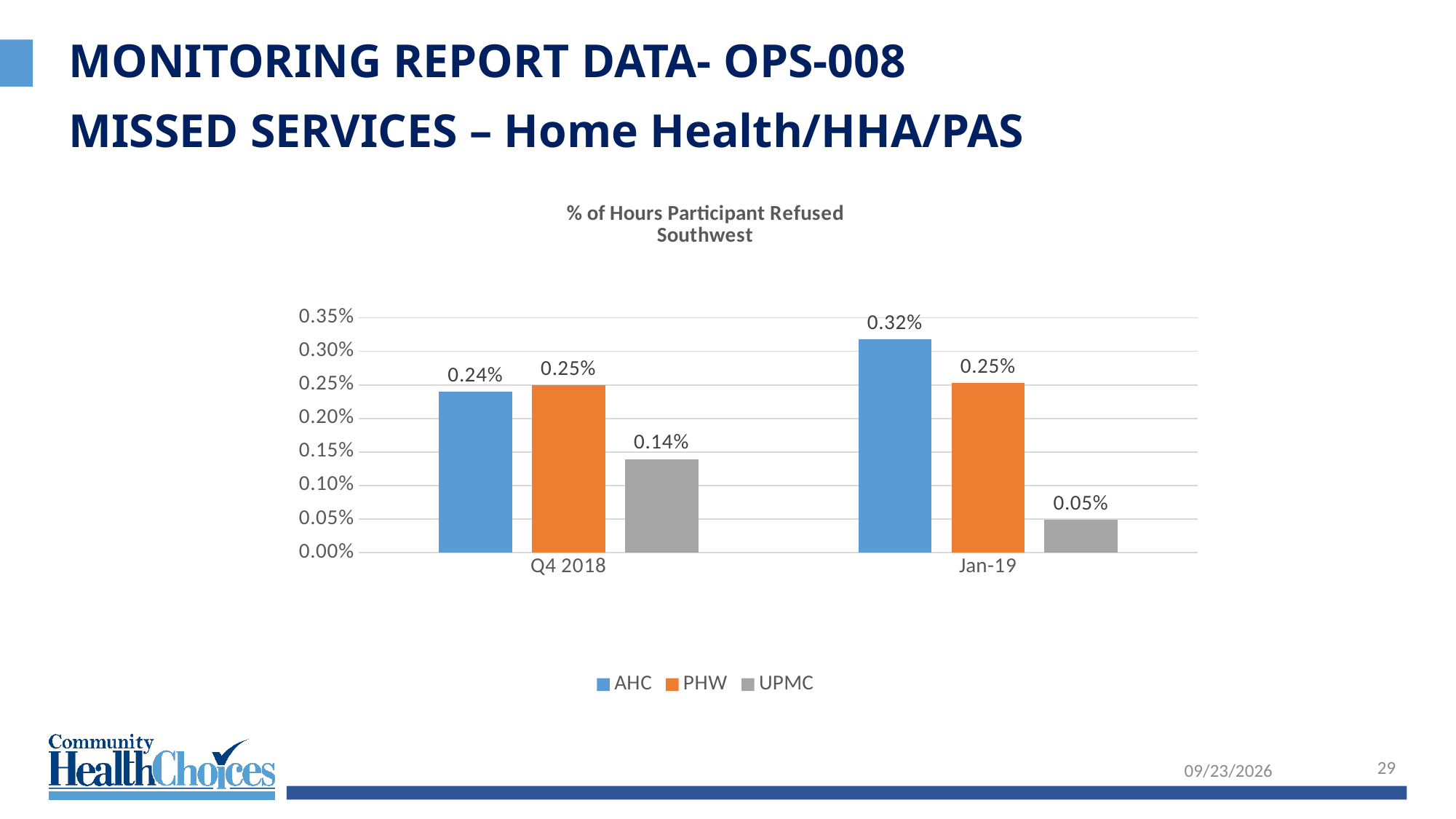
What is the value for UPMC in Jan-19? 0.05% What is the title of the chart? % of Hours Participant Refused Southwest What is the value for AHC in Q4 2018? 0.24% Which is larger: the UPMC value in Q4 2018 or the UPMC value in Jan-19? Q4 2018 Which series has the highest value in Jan-19? AHC How many categories are shown on the x axis? 2 How many series does the legend list? 3 What is the difference between the UPMC values in Q4 2018 and Jan-19? 0.09% What kind of chart is shown on the slide? Bar chart What is the value for PHW in Jan-19? 0.25% What is the difference between the AHC value in Jan-19 and the AHC value in Q4 2018? 0.08% Which series has the lowest value in Q4 2018? UPMC